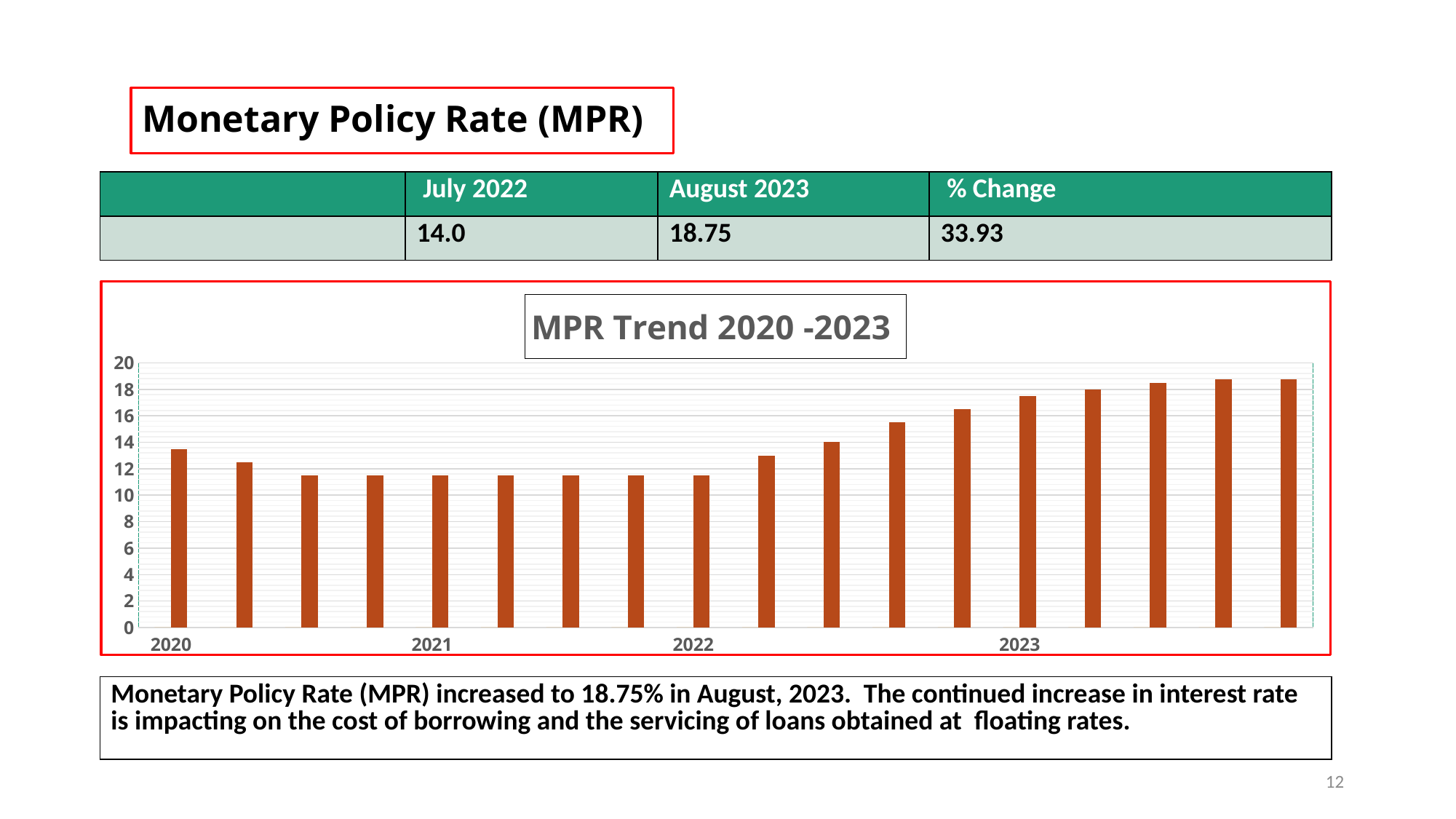
In the MPR Trend 2020 -2023 chart, do the bars rise or fall from the 2022 label to the right end of the chart? rise How many bars are plotted in the MPR Trend 2020 -2023 chart? 18 In the MPR Trend 2020 -2023 chart, is the value of the first bar at 2020 greater or less than 12? greater In the MPR Trend 2020 -2023 chart, is the value of the bar at the 2023 label greater or less than 16? greater In the MPR Trend 2020 -2023 chart, which is larger: the first bar at 2020 or the bar at the 2021 label? the first bar at 2020 What is the title of the chart on the slide? MPR Trend 2020 -2023 In the MPR Trend 2020 -2023 chart, is the value of the last bar on the right greater or less than 18? greater In the MPR Trend 2020 -2023 chart, which is larger: the first bar at 2020 or the last bar on the right? the last bar on the right In the MPR Trend 2020 -2023 chart, do the bars rise or fall from the 2020 label to the 2021 label? fall What is the highest value shown on the vertical axis of the MPR Trend 2020 -2023 chart? 20 What kind of chart is the MPR Trend 2020 -2023 chart? bar chart